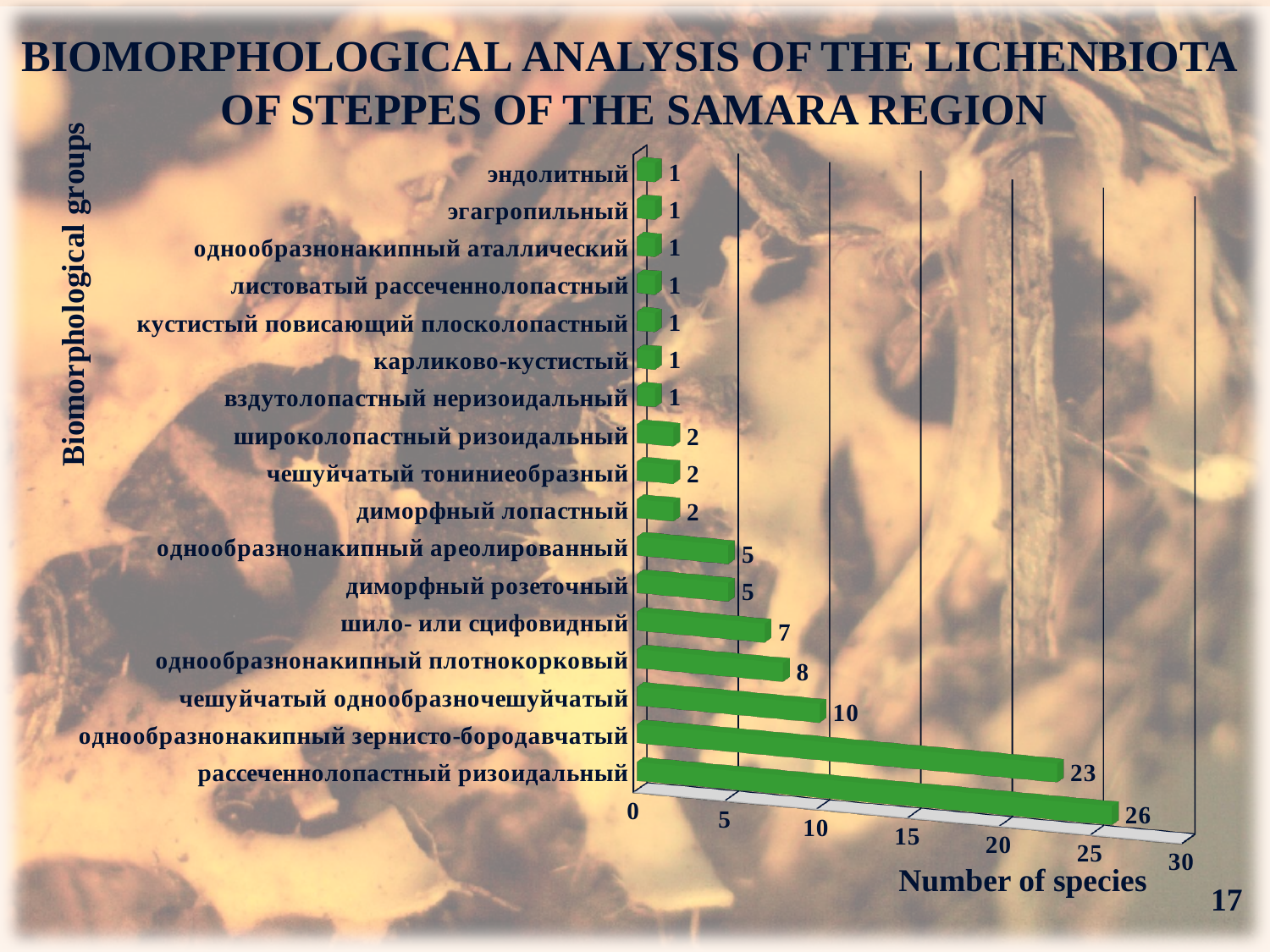
Which biomorphological group has the highest number of species? рассеченнолопастный ризоидальный What is the highest number of species shown for any group in the chart? 26 Which has more species: 'шило- или сцифовидный' or 'диморфный лопастный'? шило- или сцифовидный What is the number of species for the group 'шило- или сцифовидный'? 7 What is the number of species for the group 'чешуйчатый однообразночешуйчатый'? 10 What is the difference in number of species between 'чешуйчатый однообразночешуйчатый' and 'однообразнонакипный плотнокорковый'? 2 What is the number of species for the group 'широколопастный ризоидальный'? 2 What type of chart is shown on the slide? bar chart What is the number of species for the group 'диморфный розеточный'? 5 What is the number of species for the group 'однообразнонакипный плотнокорковый'? 8 How many biomorphological groups are plotted in the chart? 17 What is the label of the horizontal axis of the chart? Number of species